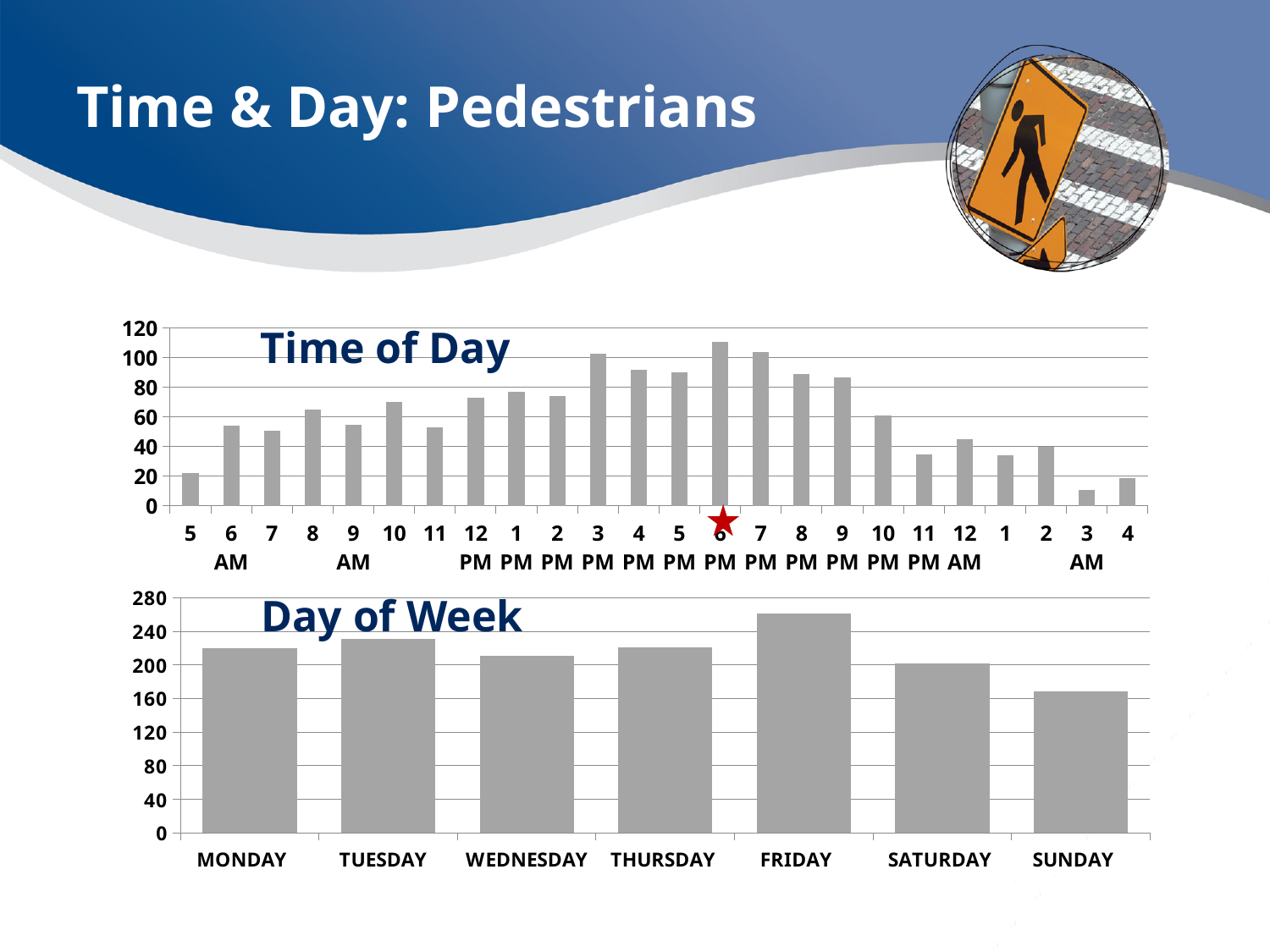
In the Day of Week chart, is the value for Sunday greater or less than 200? less In the Time of Day chart, which hour has the lowest value? 3 AM In the Time of Day chart, is the value for 10 AM greater or less than 60? greater In the Time of Day chart, is the value for 5 AM greater or less than 40? less In the Time of Day chart, which is larger, the value for 6 PM or the value for 5 AM? 6 PM In the Time of Day chart, which hour has the highest value? 6 PM In the Time of Day chart, how many hours are plotted along the x axis? 24 What kind of chart is the Day of Week chart? Bar chart In the Day of Week chart, which day has the lowest value? Sunday In the Day of Week chart, which day has the highest value? Friday